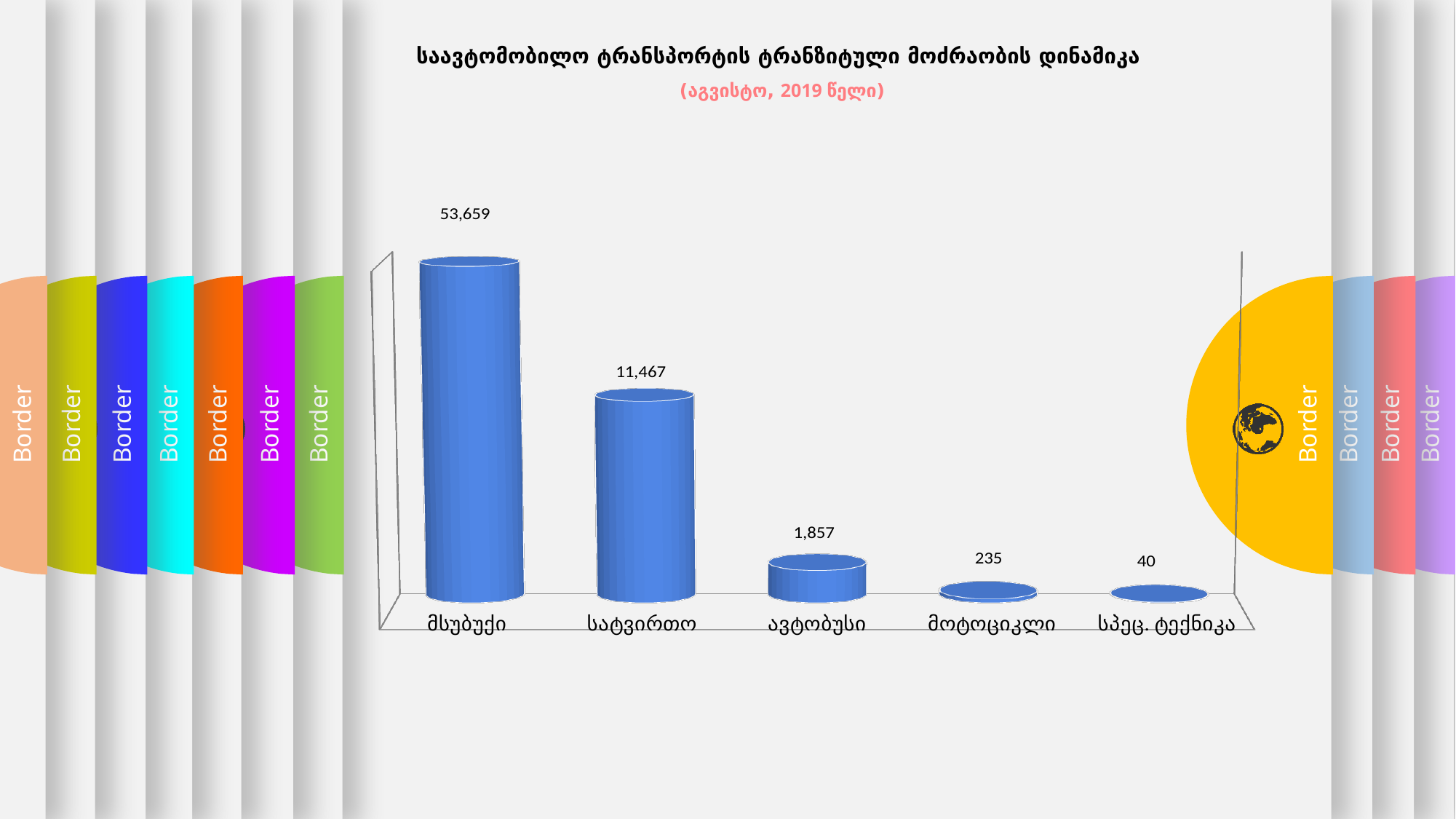
What is the value for მოტოციკლი? 235 What kind of chart is shown on the slide? bar chart Which is larger, the value for ავტობუსი or the value for მოტოციკლი? ავტობუსი Which category has the highest value? მსუბუქი How many categories are shown on the chart? 5 What is the value for სპეც. ტექნიკა? 40 Which category has the lowest value? სპეც. ტექნიკა What is the value for ავტობუსი? 1,857 What is the value for მსუბუქი? 53,659 What period is given in the chart's subtitle? აგვისტო, 2019 წელი What is the difference between the values for მსუბუქი and სატვირთო? 42,192 What is the value for სატვირთო? 11,467